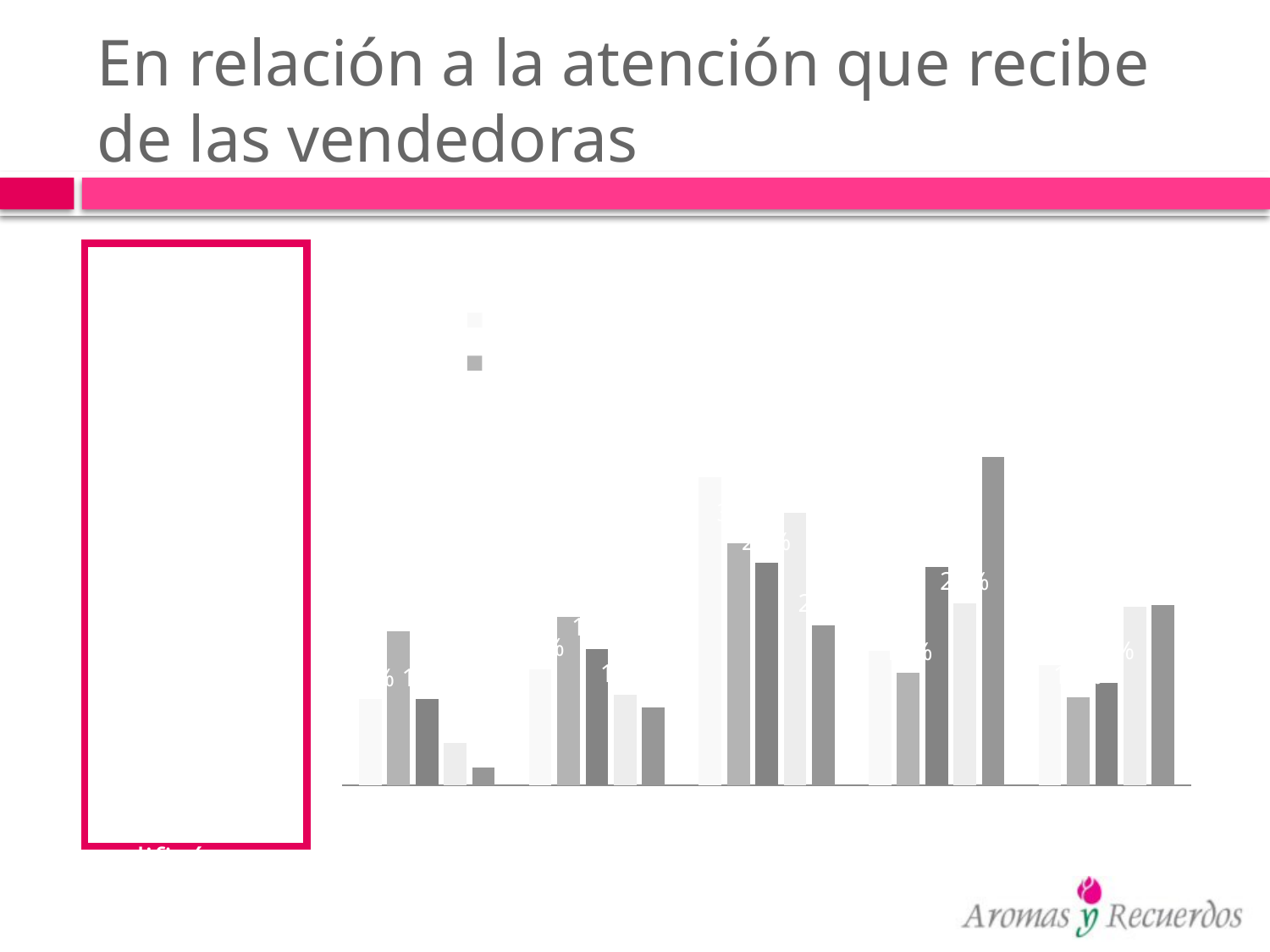
Are the bars in the chart vertical or horizontal? vertical How many bars are there in each group? 5 Counting from the left, which group of bars contains the shortest bar on the chart? the first group What kind of chart is shown on the slide? bar chart Counting from the left, which group of bars contains the tallest bar on the chart? the fourth group How many groups of bars are plotted along the x axis? 5